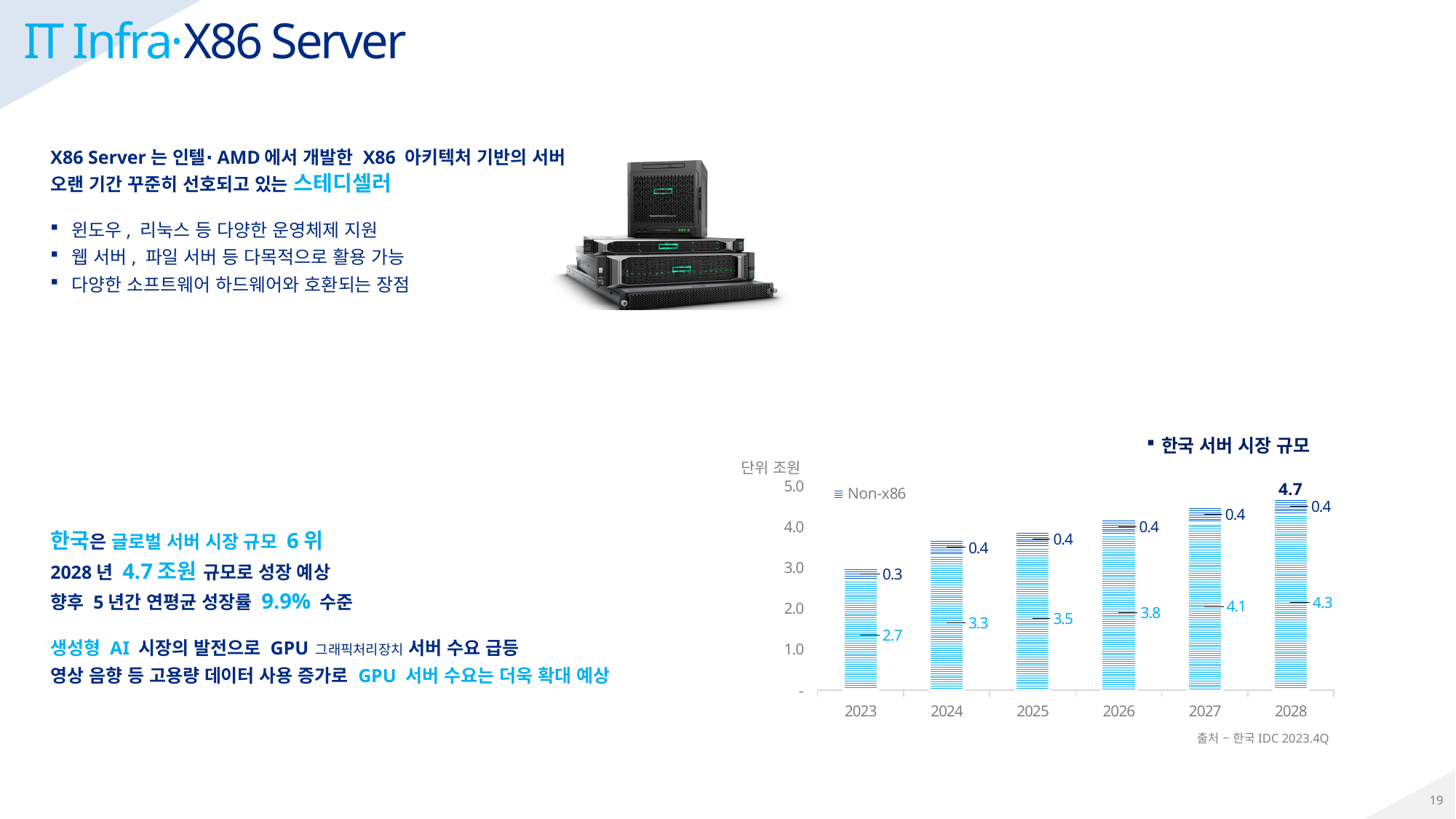
In the 한국 서버 시장 규모 chart, which year has the shortest bar? 2023 In the 한국 서버 시장 규모 chart, what is the total labeled on top of the 2028 bar? 4.7 In the 한국 서버 시장 규모 chart, which year has the tallest bar? 2028 How many years are shown on the x axis of the 한국 서버 시장 규모 chart? 6 In the 한국 서버 시장 규모 chart, is the Non-x86 value larger in 2023 or 2024? 2024 In the 한국 서버 시장 규모 chart, is the total height of the 2027 bar greater or less than 4.0? greater In the 한국 서버 시장 규모 chart, what is the total of the 2023 stacked bar (2.7 + 0.3)? 3.0 In the 한국 서버 시장 규모 chart, do the bar totals rise or fall from 2023 to 2028? rise In the 한국 서버 시장 규모 chart, what is the difference between the lower segment values for 2028 and 2023? 1.6 In the 한국 서버 시장 규모 chart, what is the Non-x86 value for 2023? 0.3 In the 한국 서버 시장 규모 chart, what is the value of the lower (light blue) segment of the 2025 bar? 3.5 In the 한국 서버 시장 규모 chart, what is the value of the lower (light blue) segment of the 2028 bar? 4.3